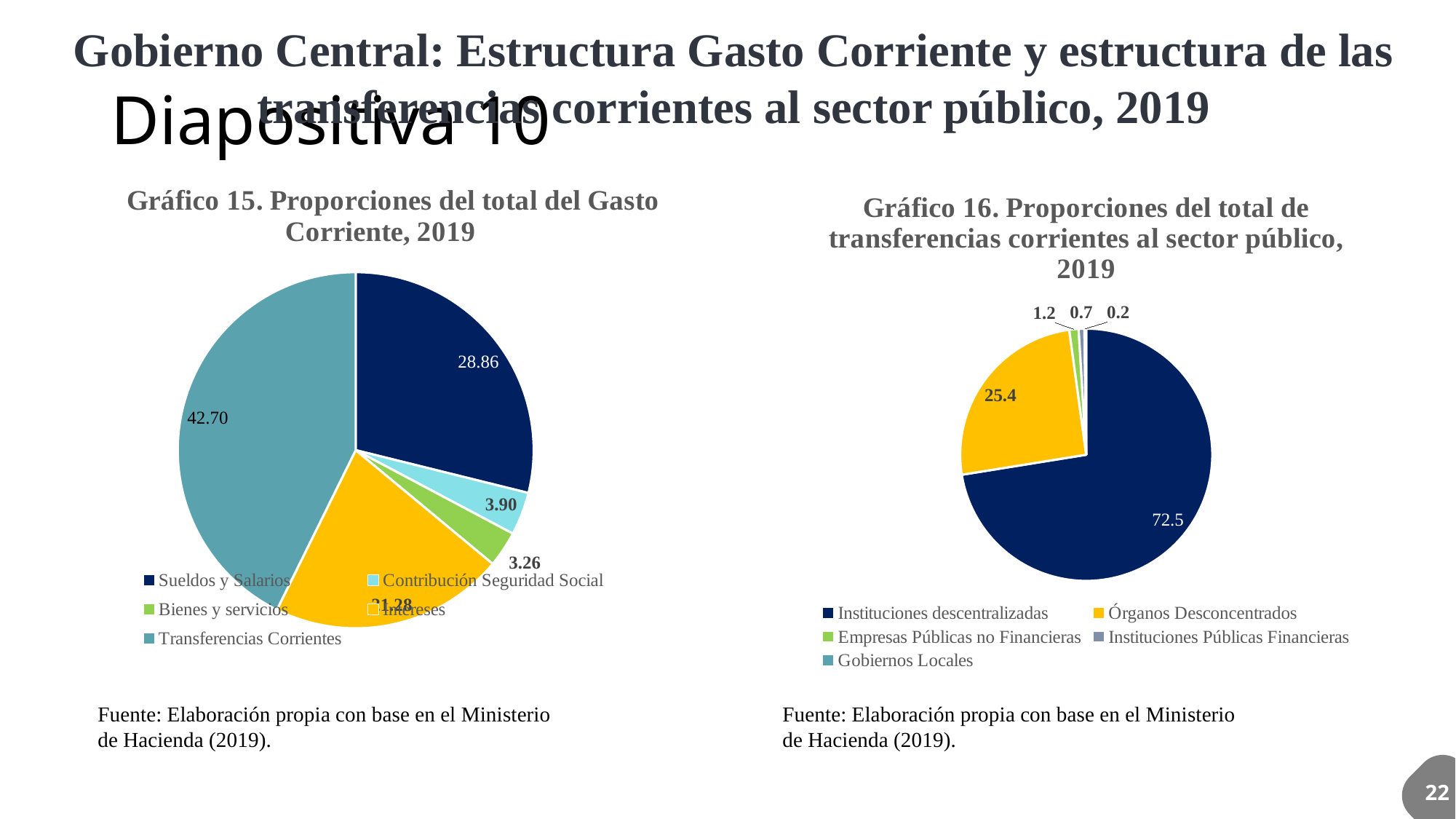
In Gráfico 16, what is the value for Órganos Desconcentrados? 25.4 In Gráfico 16, which category has the smallest share? Gobiernos Locales In Gráfico 15, which category has the largest share? Transferencias Corrientes In Gráfico 16, what is the value for Instituciones descentralizadas? 72.5 What type of chart is Gráfico 15? Pie chart In Gráfico 15, which is larger, Contribución Seguridad Social or Bienes y servicios? Contribución Seguridad Social How many categories does the legend of Gráfico 16 list? 5 In Gráfico 15, what is the value for Sueldos y Salarios? 28.86 In Gráfico 15, what is the value for Transferencias Corrientes? 42.70 In Gráfico 15, what is the value for Contribución Seguridad Social? 3.90 In Gráfico 15, what is the difference between Transferencias Corrientes and Sueldos y Salarios? 13.84 In Gráfico 16, what is the difference between Instituciones descentralizadas and Órganos Desconcentrados? 47.1